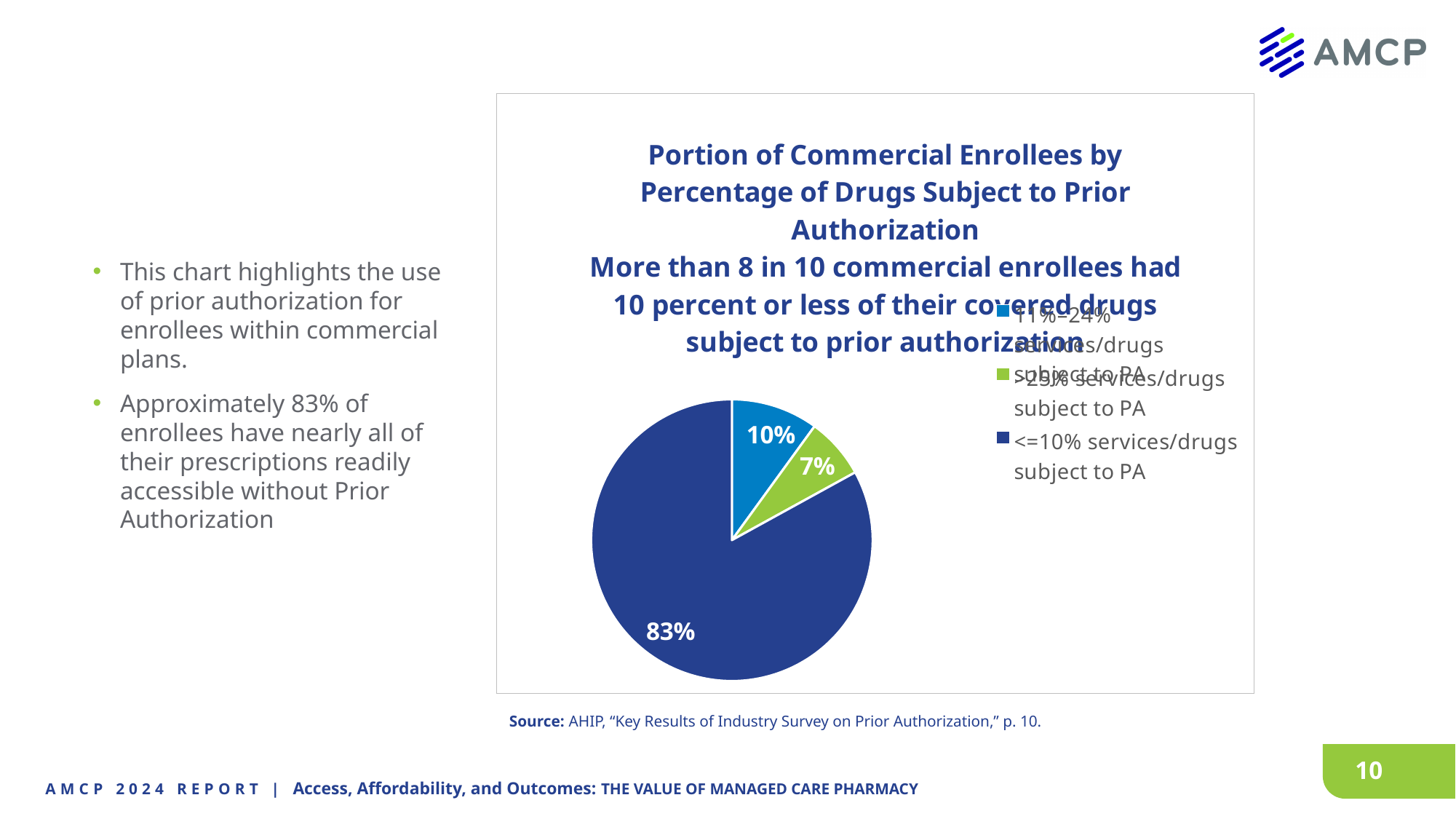
What is the source cited below the chart? AHIP, "Key Results of Industry Survey on Prior Authorization," p. 10. What share of commercial enrollees had >25% services/drugs subject to PA? 7% Which category has the smallest slice of the pie? >25% services/drugs subject to PA What colour is the slice for >25% services/drugs subject to PA? green What share of commercial enrollees had <=10% services/drugs subject to PA? 83% How many slices does the pie chart have? 3 What is the value shown on the blue slice between the 83% and 7% slices? 10% Which is larger: the slice for <=10% services/drugs subject to PA or the slice for >25% services/drugs subject to PA? <=10% services/drugs subject to PA What is the difference between the largest slice (83%) and the smallest slice (7%)? 76% What kind of chart is shown on the slide? pie chart Which category has the largest slice of the pie? <=10% services/drugs subject to PA